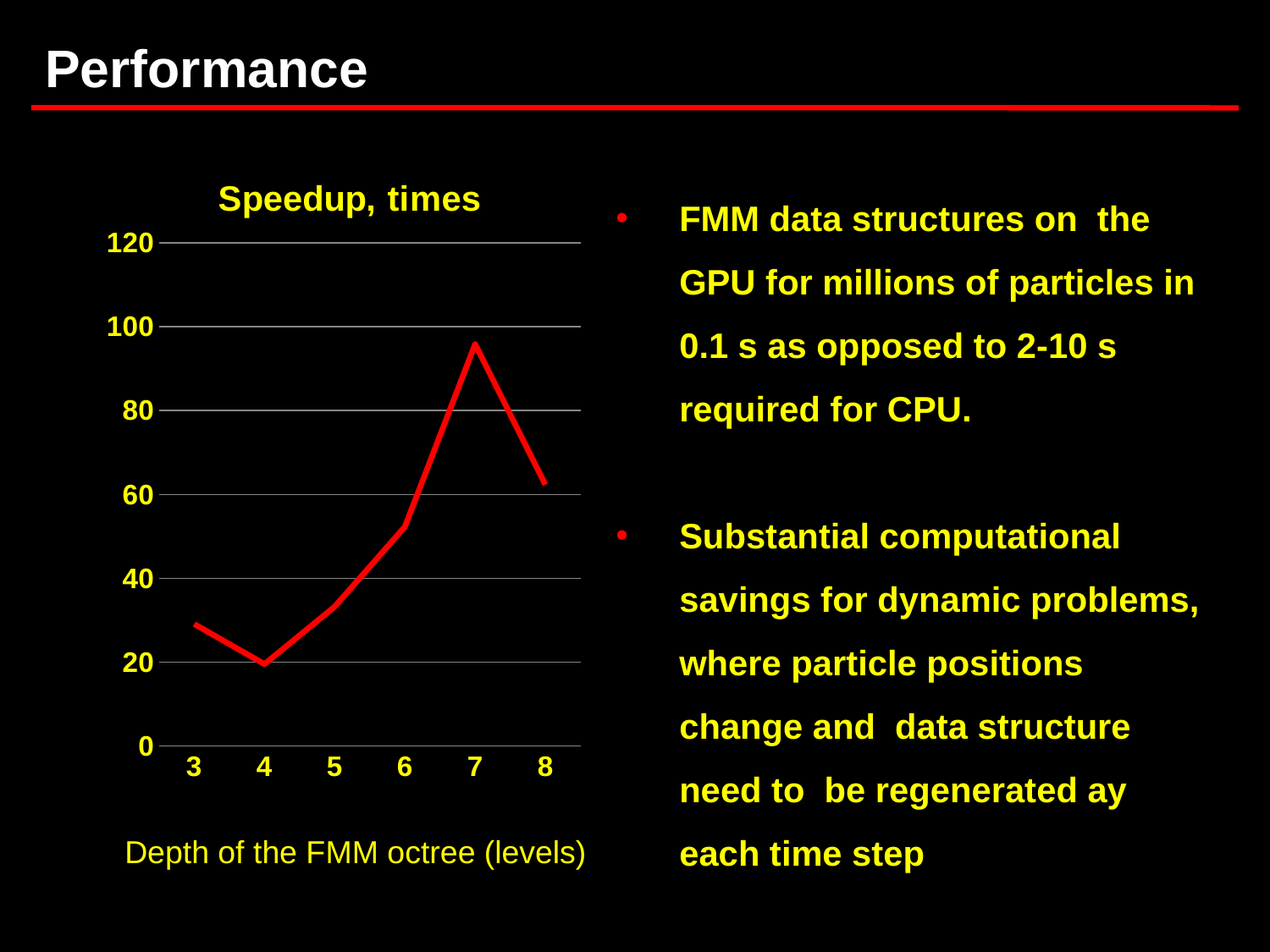
Does the speedup rise or fall from depth 4 to depth 7? rise Is the speedup at depth 7 greater or less than 80? greater What is the x-axis label of the chart? Depth of the FMM octree (levels) Is the speedup at depth 4 greater or less than 40? less How many data points are plotted on the line? 6 Which has the larger speedup, depth 6 or depth 8? depth 8 What kind of chart is shown on the slide? line chart What is the title of the chart? Speedup, times At which octree depth is the speedup lowest? 4 Is the speedup at depth 6 greater or less than 60? less At which octree depth is the speedup highest? 7